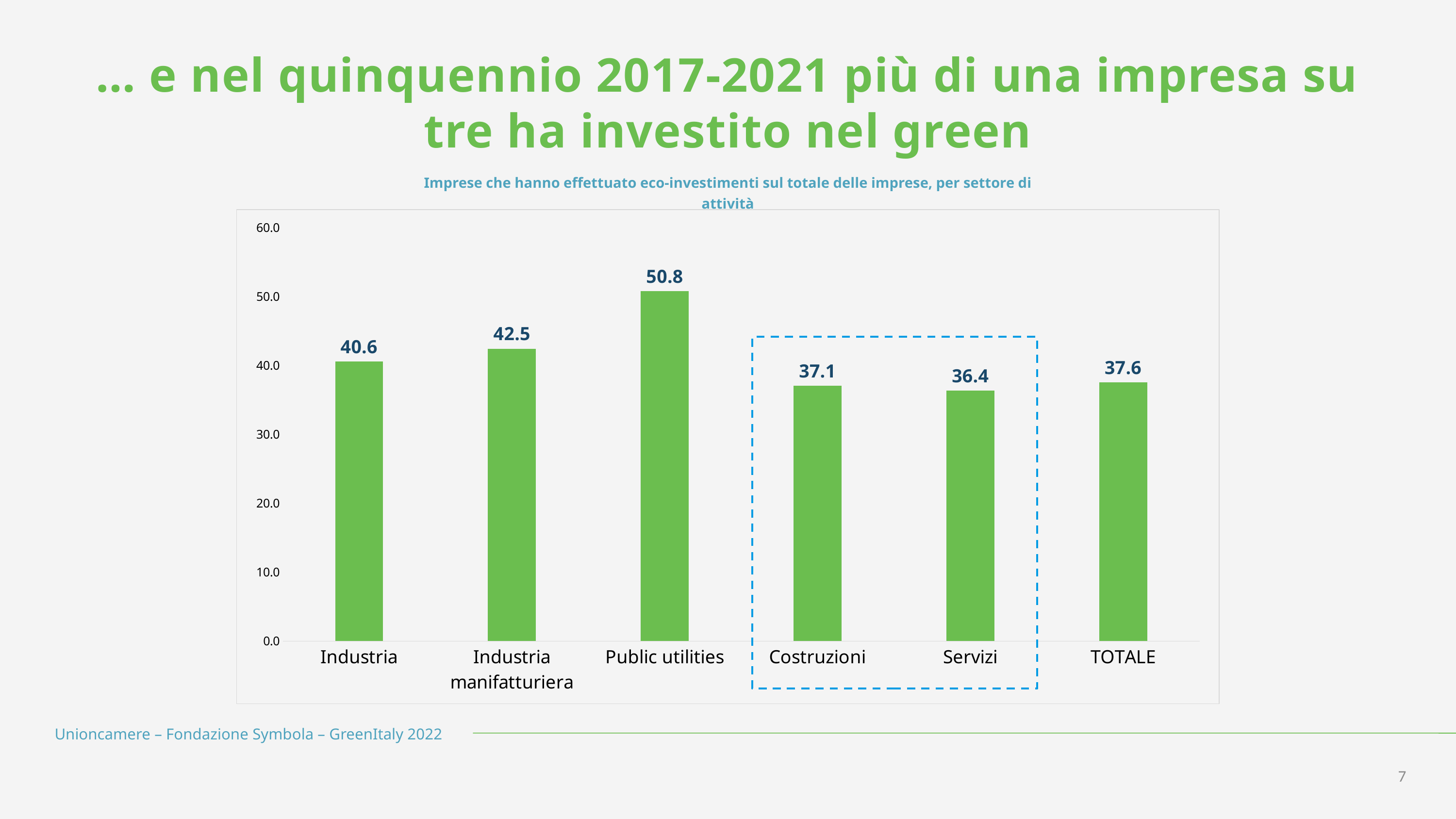
What is the difference between the values for Costruzioni and Servizi? 0.7 What is the value for Industria manifatturiera? 42.5 What is the difference between the values for Public utilities and Industria? 10.2 What is the value for Public utilities? 50.8 What is the value for TOTALE? 37.6 Which category has the highest value? Public utilities Is the value for Servizi greater or less than 40.0? less Which two categories are enclosed by the dashed blue box? Costruzioni and Servizi Which is larger, the value for Industria or the value for Costruzioni? Industria What kind of chart is shown on the slide? bar chart How many categories are shown on the x axis? 6 Which category has the lowest value? Servizi